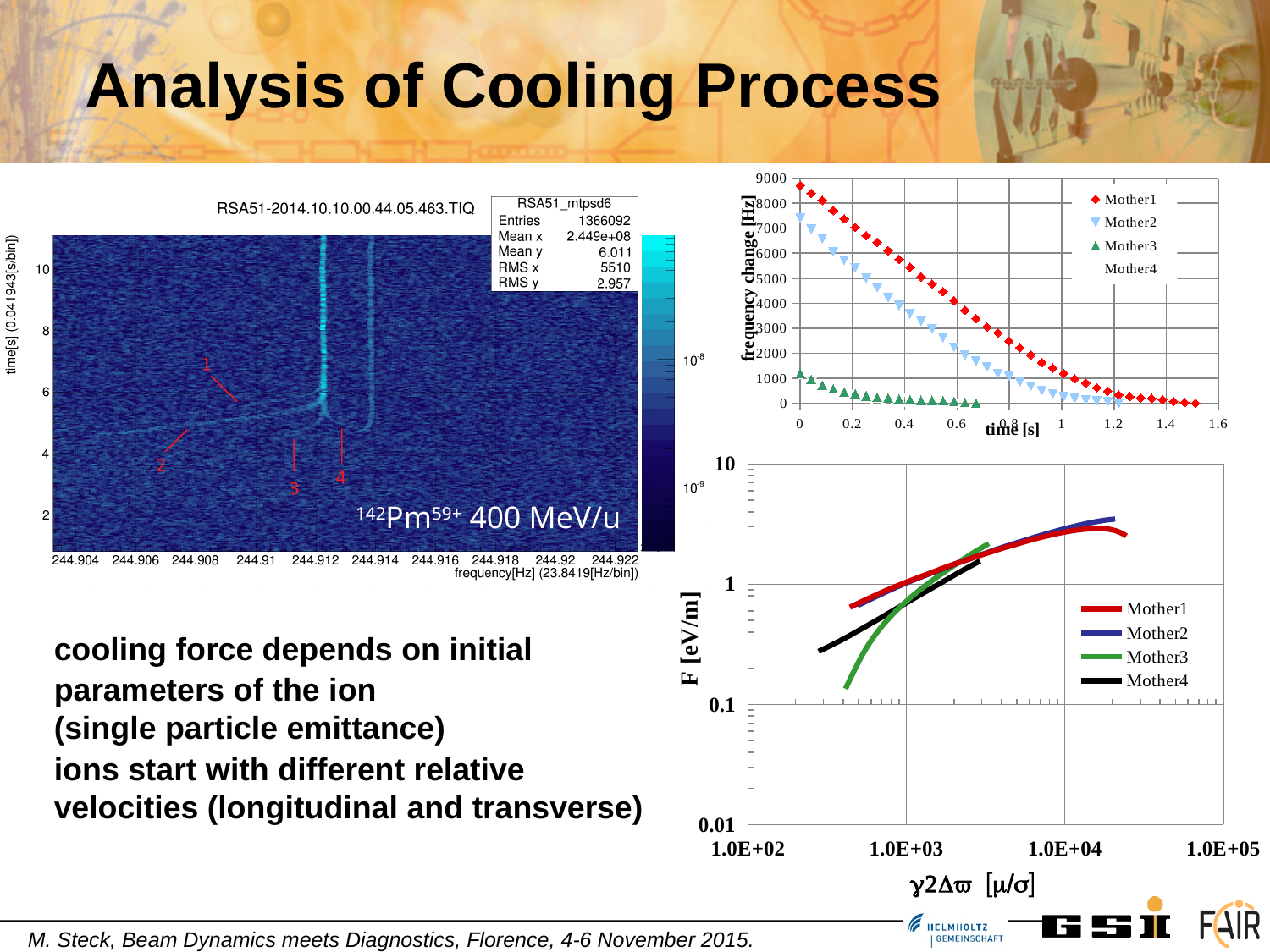
In the top-right chart (frequency change vs time), which series has the highest frequency change at time 0? Mother1 What kind of chart is the bottom-right chart (F [eV/m] vs γ2Δϖ)? line chart In the bottom-right chart (F [eV/m] vs γ2Δϖ), how many series does the legend list? 4 In the top-right chart (frequency change vs time), at time 0.2 s, which is larger: Mother2 or Mother3? Mother2 In the top-right chart (frequency change vs time), is the value for Mother3 at time 0 greater or less than 2000? less In the bottom-right chart (F [eV/m] vs γ2Δϖ), does F rise or fall as γ2Δϖ increases? rise In the top-right chart (frequency change vs time), is the value for Mother1 at time 0 greater or less than 8000? greater In the top-right chart, what is the label of the y axis? frequency change [Hz] In the top-right chart (frequency change vs time), how many series does the legend list? 4 In the top-right chart (frequency change vs time), does the frequency change for Mother1 rise or fall as time increases? fall In the bottom-right chart (F [eV/m] vs γ2Δϖ), what colour is the Mother4 line? black